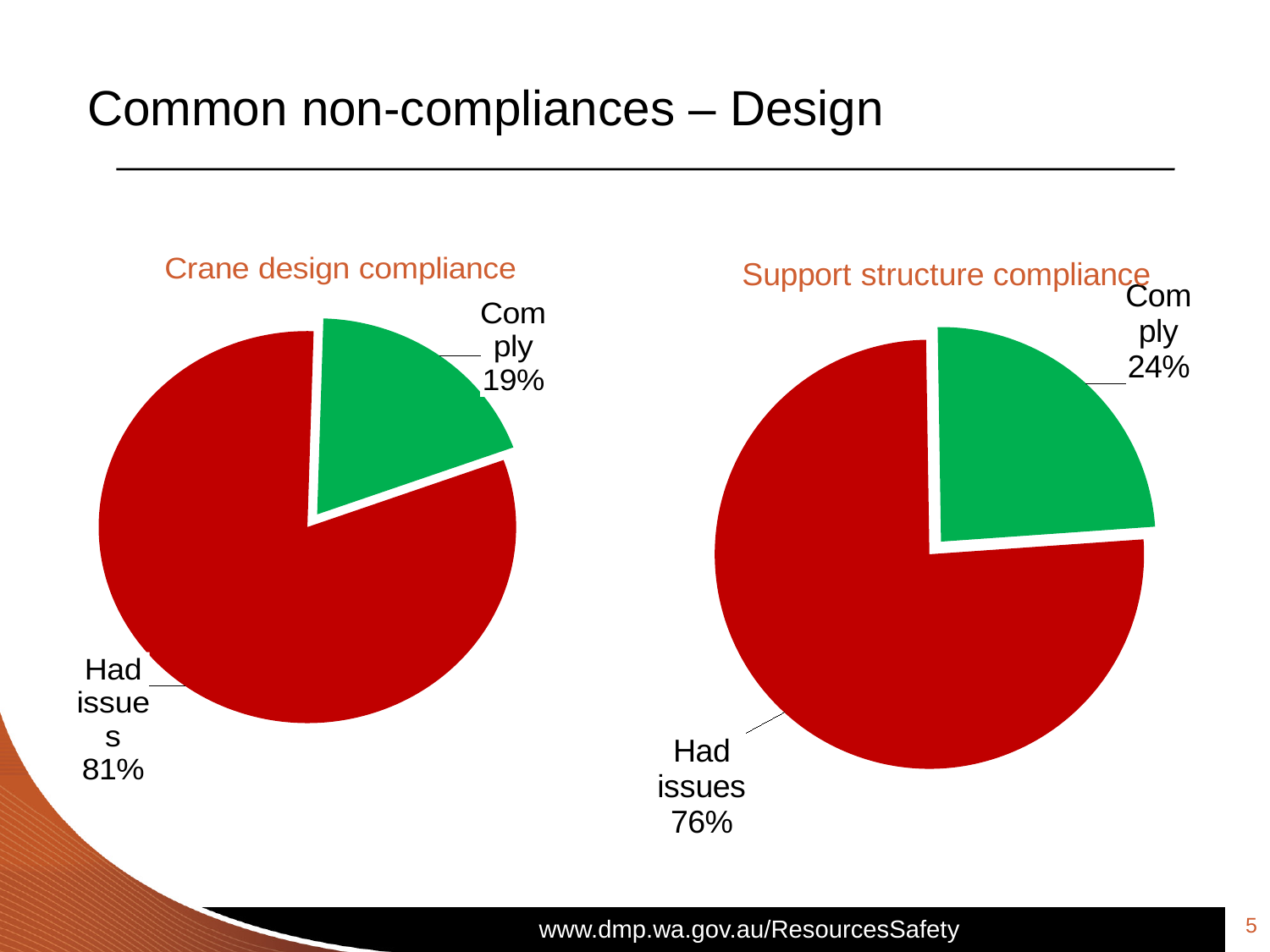
In the 'Support structure compliance' chart, which slice is the smallest? Comply In the 'Support structure compliance' chart, what share of the pie is 'Comply'? 24% How many slices does the 'Support structure compliance' chart have? 2 In the 'Crane design compliance' chart, what is the difference between the 'Had issues' and 'Comply' shares? 62% In the 'Crane design compliance' chart, what share of the pie is 'Comply'? 19% What kind of chart is the 'Crane design compliance' chart? Pie chart In the 'Crane design compliance' chart, which slice is the largest? Had issues In the 'Crane design compliance' chart, what share of the pie is 'Had issues'? 81% In the 'Crane design compliance' chart, what colour is the 'Comply' slice? Green In the 'Support structure compliance' chart, what is the difference between the 'Had issues' and 'Comply' shares? 52% Which chart has the larger 'Comply' share, 'Crane design compliance' or 'Support structure compliance'? Support structure compliance